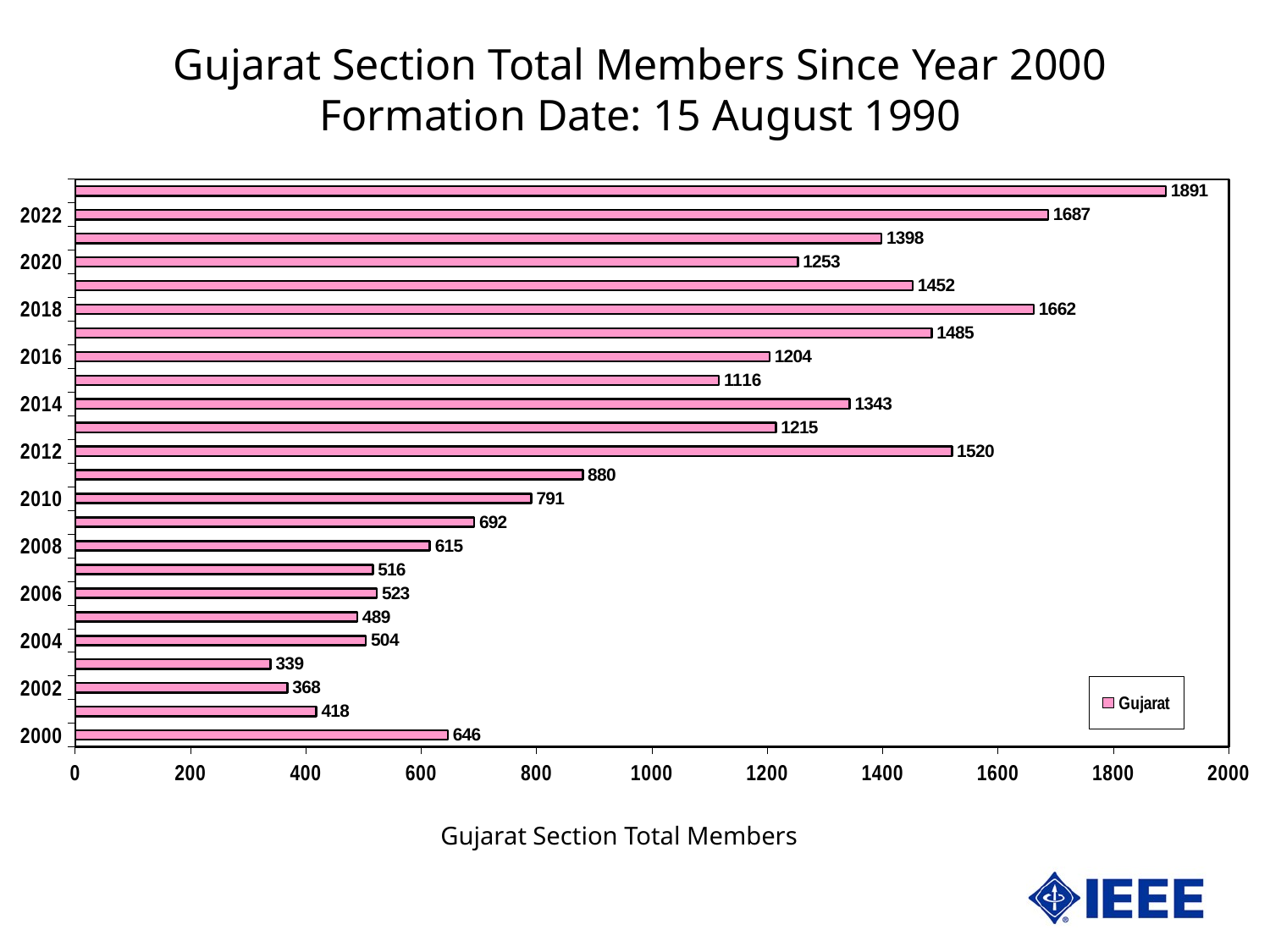
Which is larger, the value for 2014 or the value for 2016? 2014 What series name does the legend show? Gujarat What is the value for 2012? 1520 Is the value for 2010 greater or less than 800? less How many bars are plotted on the chart? 24 What is the difference between the values for 2022 and 2020? 434 What kind of chart is shown? bar chart What is the value for 2018? 1662 What is the value for 2022? 1687 What is the value for 2000? 646 What is the lowest value shown on the chart? 339 What is the highest value shown on the chart? 1891